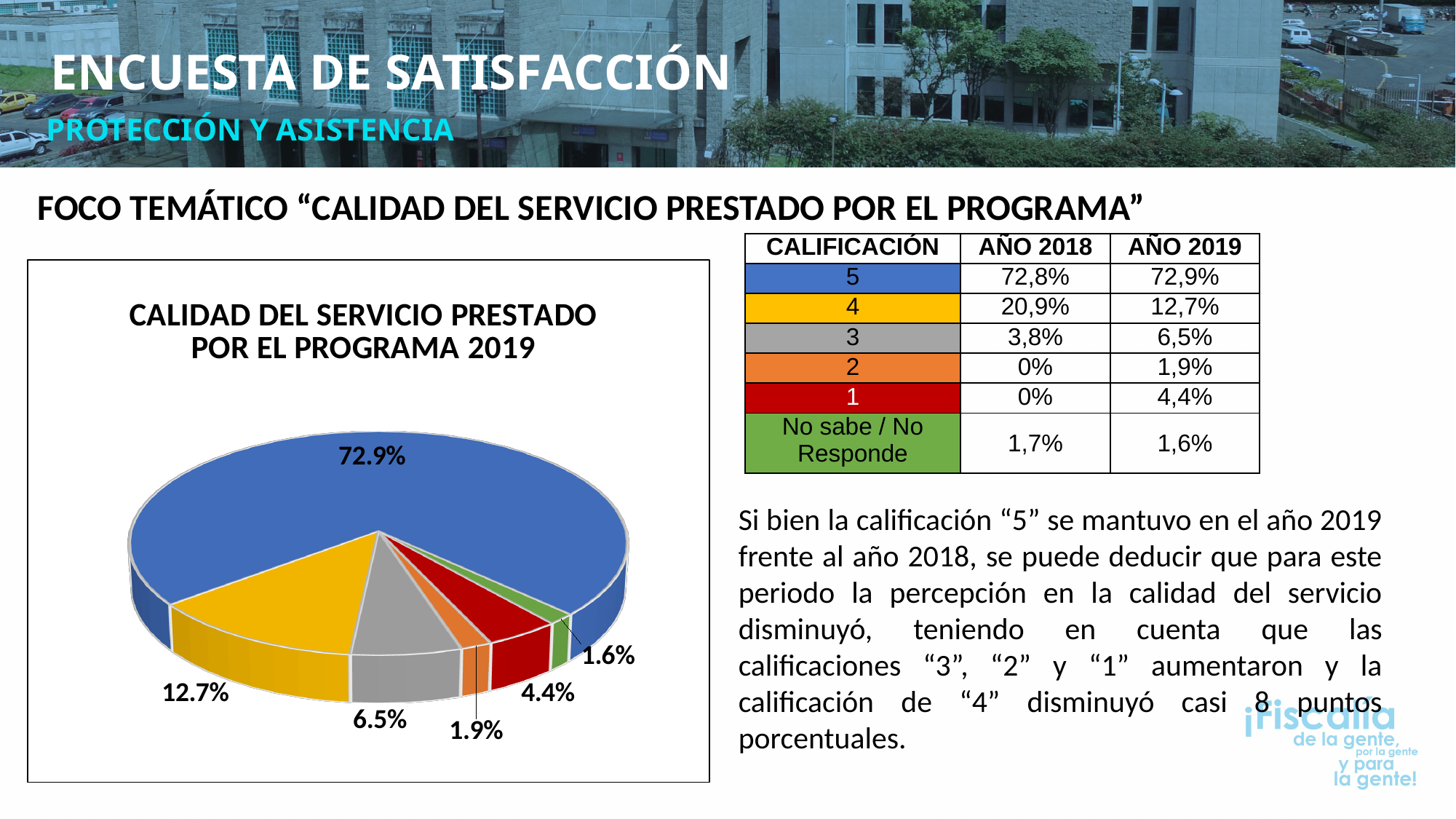
What is the value of the largest slice in the pie chart? 72.9% What value is labelled on the red slice of the pie chart? 4.4% What is the difference in percentage points between the blue slice (72.9%) and the yellow slice (12.7%) in the pie chart? 60.2 What is the value of the smallest slice in the pie chart? 1.6% How many slices does the pie chart have? 6 What value is labelled on the blue slice of the pie chart? 72.9% What value is labelled on the gray slice of the pie chart? 6.5% What value is labelled on the yellow slice of the pie chart? 12.7% What kind of chart is shown on the slide? Pie chart Which slice is larger in the pie chart, the red slice or the orange slice? Red slice What share of the pie does the blue slice represent? 72.9% What is the title of the pie chart? CALIDAD DEL SERVICIO PRESTADO POR EL PROGRAMA 2019